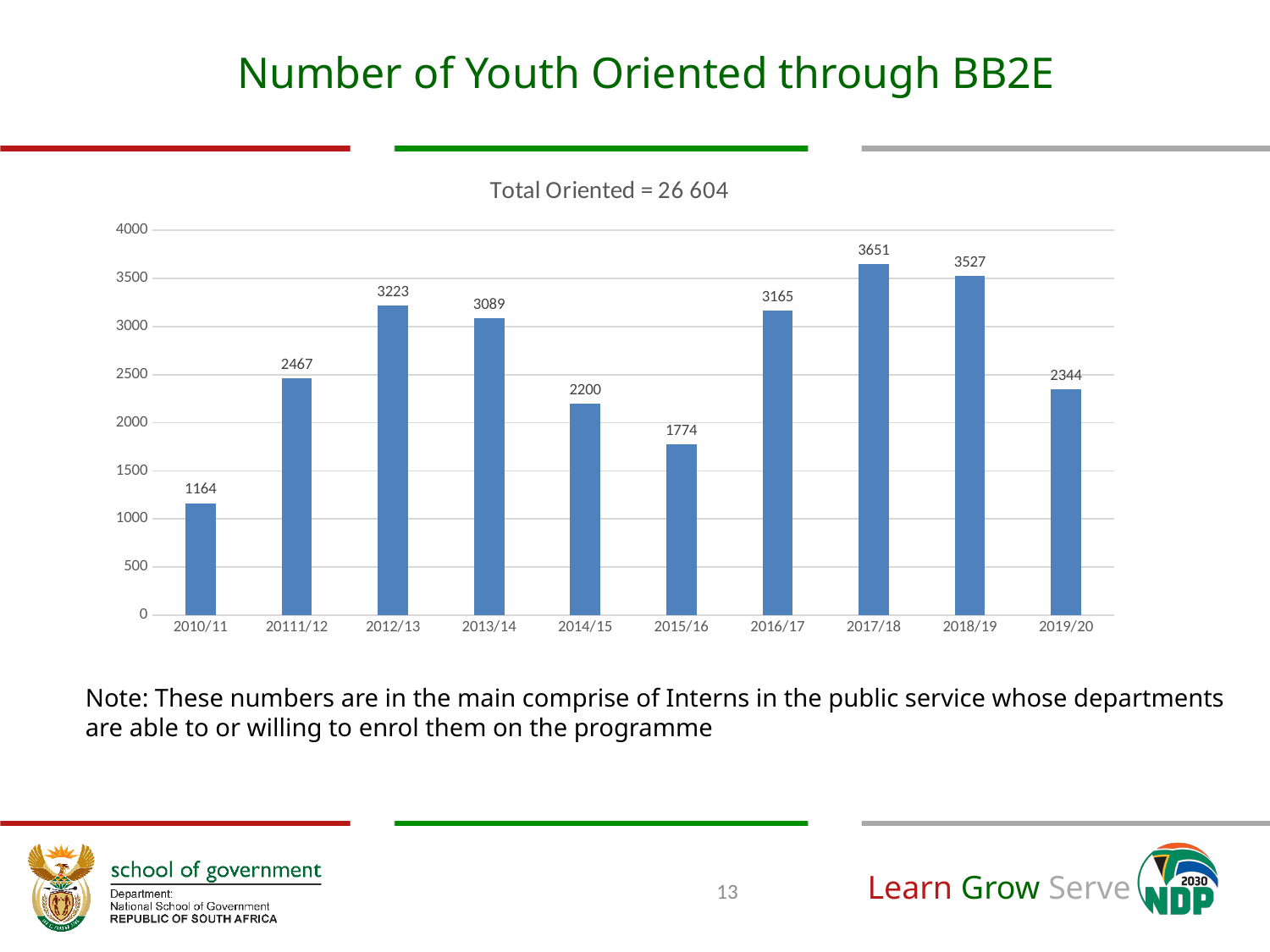
What is the difference between the values for 2012/13 and 2013/14? 134 What is the number of youth oriented in 2010/11? 1164 Which year has the lowest number of youth oriented? 2010/11 What is the chart's title? Total Oriented = 26 604 How many years are shown on the x axis? 10 Which is larger, the value for 2014/15 or the value for 2019/20? 2019/20 What kind of chart is shown on the slide? Bar chart Is the value for 2016/17 greater or less than 3000? greater What is the number of youth oriented in 2017/18? 3651 What is the value shown for 2015/16? 1774 Which year has the highest number of youth oriented? 2017/18 What is the difference between the values for 2017/18 and 2018/19? 124